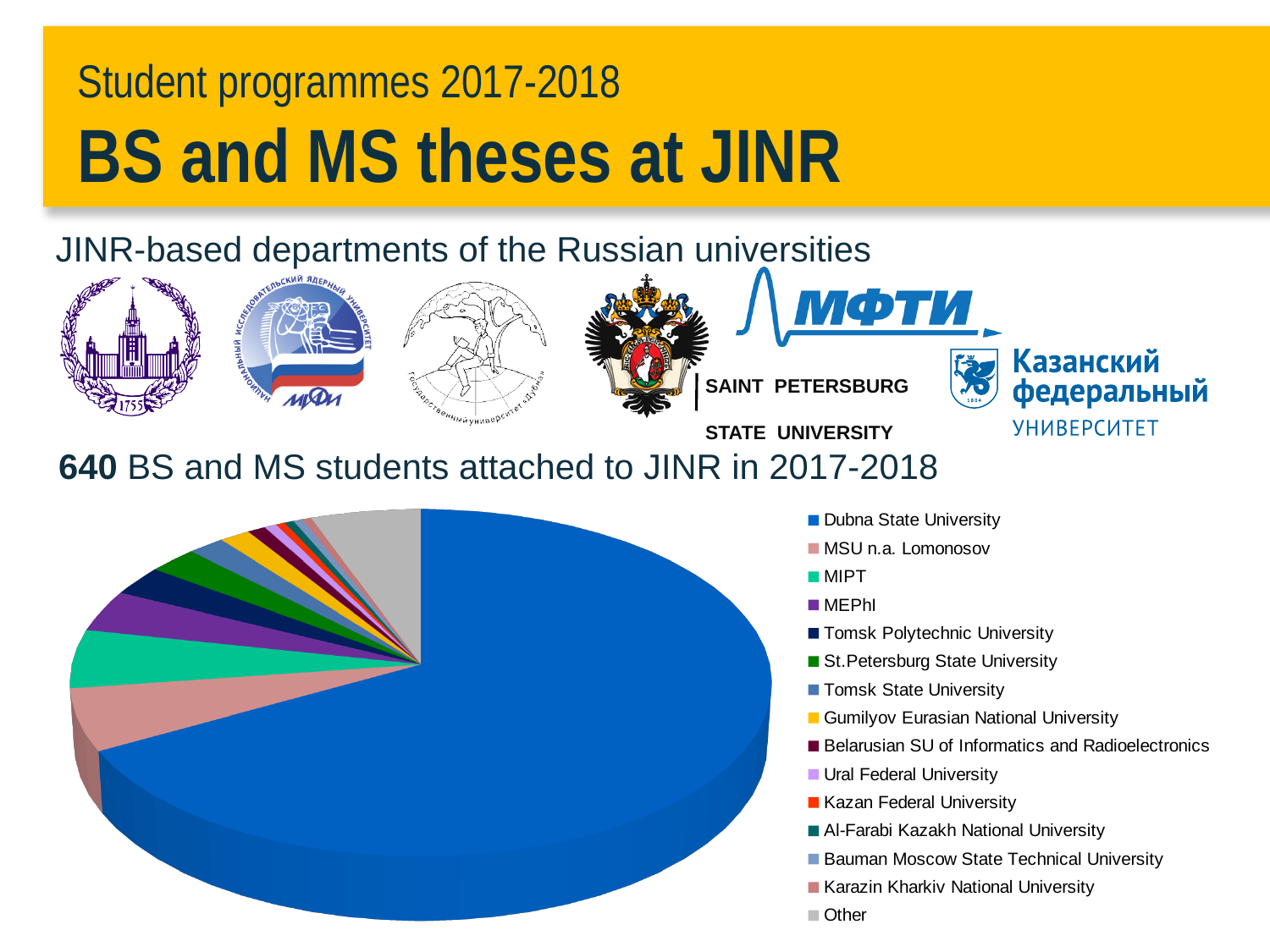
Which slice is larger in the pie chart, Dubna State University or Other? Dubna State University How many categories does the pie chart's legend list? 15 What kind of chart is shown on the slide? pie chart Which category is listed last in the pie chart's legend? Other Which slice is larger in the pie chart, Dubna State University or MSU n.a. Lomonosov? Dubna State University What colour is used for Dubna State University in the pie chart? blue Does the largest slice of the pie chart account for more or less than half of the pie? more Which category has the largest slice in the pie chart? Dubna State University